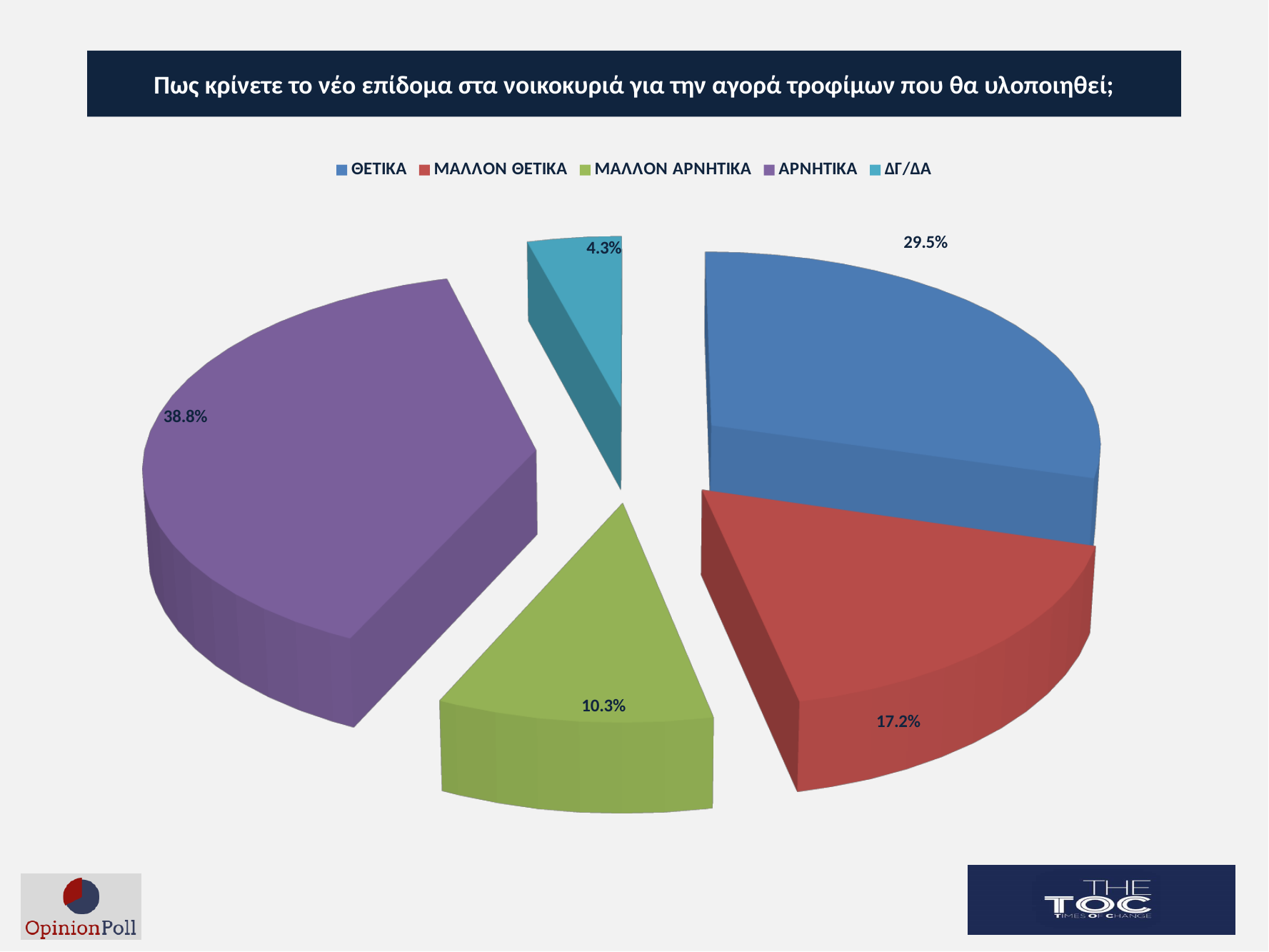
What is the combined percentage of ΘΕΤΙΚΑ and ΜΑΛΛΟΝ ΘΕΤΙΚΑ? 46.7% What is the difference in percentage points between ΑΡΝΗΤΙΚΑ and ΘΕΤΙΚΑ? 9.3 What percentage of respondents answered ΔΓ/ΔΑ? 4.3% What percentage of respondents answered ΑΡΝΗΤΙΚΑ? 38.8% What percentage of respondents answered ΘΕΤΙΚΑ? 29.5% Which colour represents ΑΡΝΗΤΙΚΑ in the pie chart? Purple Which response category has the largest share of the pie? ΑΡΝΗΤΙΚΑ What percentage of respondents answered ΜΑΛΛΟΝ ΘΕΤΙΚΑ? 17.2% How many response categories are shown in the pie chart? 5 What type of chart is shown on the slide? Pie chart Which response category has the smallest share of the pie? ΔΓ/ΔΑ Which is larger, the share for ΜΑΛΛΟΝ ΘΕΤΙΚΑ or the share for ΜΑΛΛΟΝ ΑΡΝΗΤΙΚΑ? ΜΑΛΛΟΝ ΘΕΤΙΚΑ